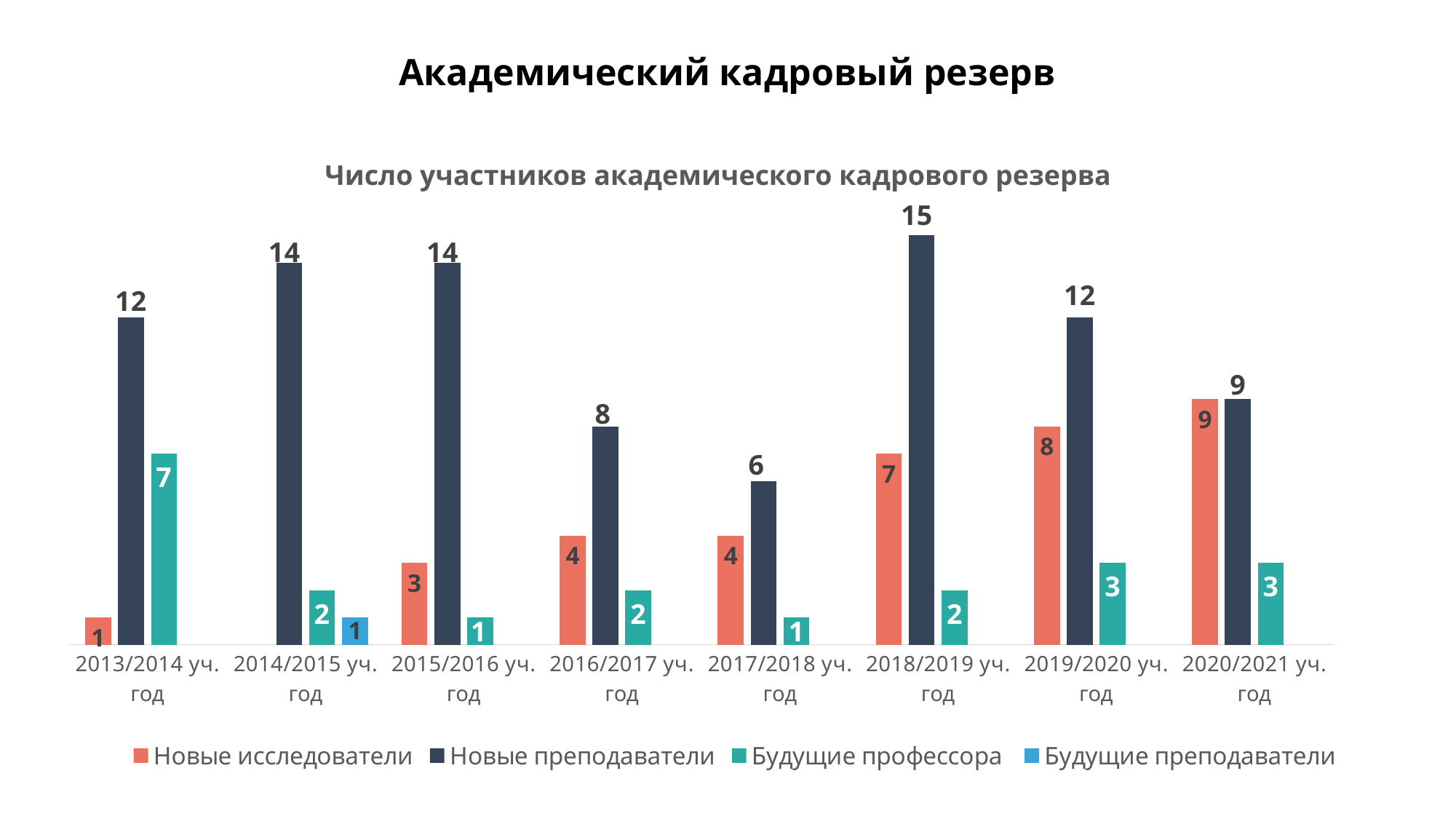
What is the value for Будущие профессора in 2013/2014 уч. год? 7 What is the difference between Новые преподаватели and Новые исследователи in 2019/2020 уч. год? 4 What is the value for Новые исследователи in 2020/2021 уч. год? 9 Which is larger in 2016/2017 уч. год: Новые исследователи or Будущие профессора? Новые исследователи How many series does the legend list? 4 What kind of chart is shown on the slide? Bar chart What is the value for Новые преподаватели in 2018/2019 уч. год? 15 In which academic year is the value for Новые преподаватели the lowest? 2017/2018 уч. год In which academic year is the value for Новые преподаватели the highest? 2018/2019 уч. год In which academic year does the series Будущие преподаватели appear? 2014/2015 уч. год Does the value for Новые исследователи rise or fall from 2015/2016 уч. год to 2020/2021 уч. год? Rise How many academic years are shown on the x axis? 8